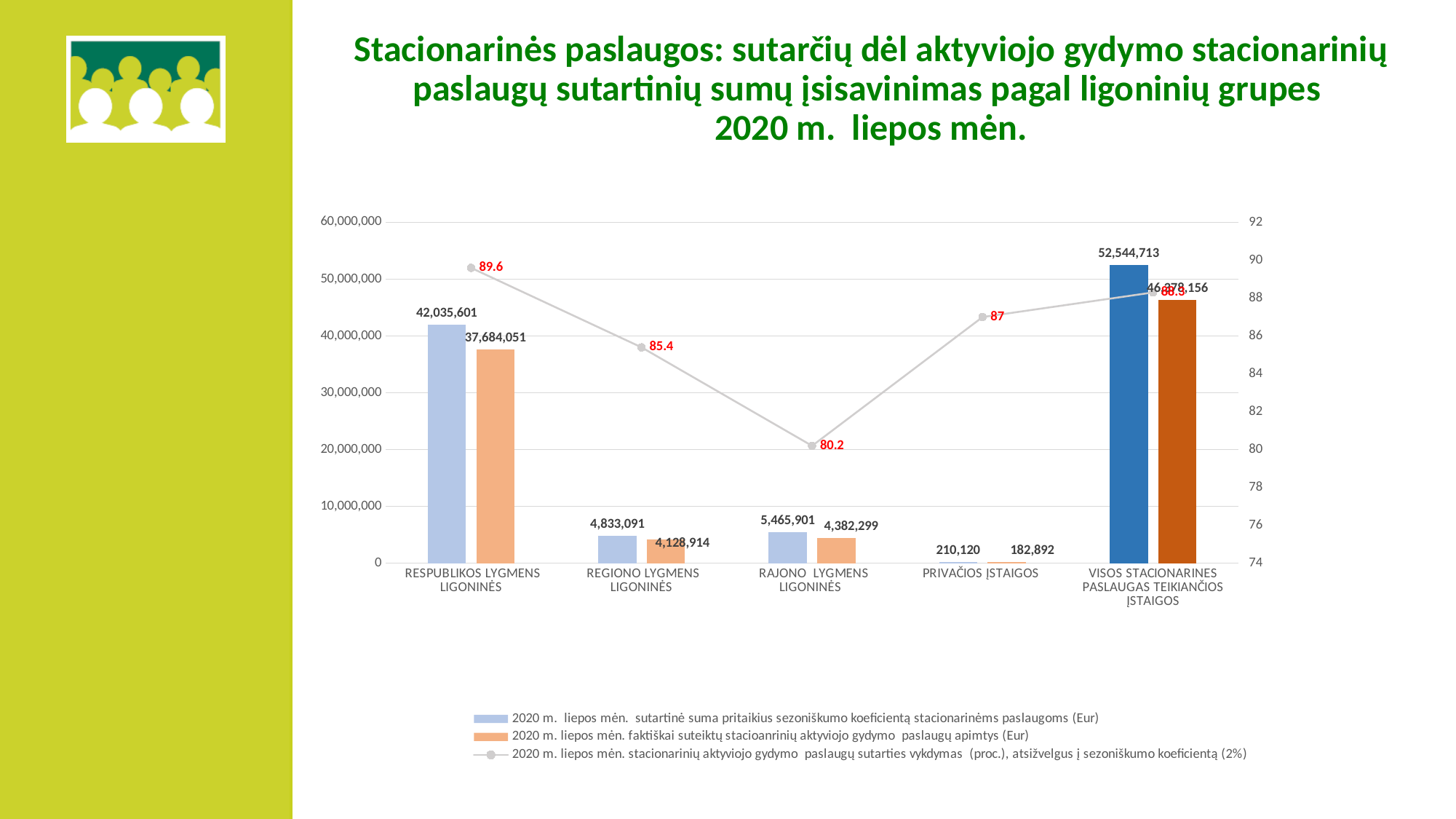
Which category has the lowest actual services (faktiškai suteiktų) bar? PRIVAČIOS ĮSTAIGOS What is the difference between the contracted sum and the actual services value for RESPUBLIKOS LYGMENS LIGONINĖS? 4,351,550 What is the faktiškai suteiktų paslaugų apimtys (actual services) value for REGIONO LYGMENS LIGONINĖS? 4,128,914 What kind of chart is shown on the slide? Bar and line chart How many categories are shown on the x axis? 5 What is the difference between the line values for RESPUBLIKOS LYGMENS LIGONINĖS and REGIONO LYGMENS LIGONINĖS? 4.2 Which category has the highest contracted sum (sutartinė suma) bar? VISOS STACIONARINES PASLAUGAS TEIKIANČIOS ĮSTAIGOS What is the 2020 m. liepos mėn. sutartinė suma (contracted sum) for RESPUBLIKOS LYGMENS LIGONINĖS? 42,035,601 Which category has the lowest value on the sutarties vykdymas (proc.) line? RAJONO LYGMENS LIGONINĖS Which has the larger contracted sum: REGIONO LYGMENS LIGONINĖS or RAJONO LYGMENS LIGONINĖS? RAJONO LYGMENS LIGONINĖS How many series does the legend list? 3 What is the sutarties vykdymas (proc.) line value for RAJONO LYGMENS LIGONINĖS? 80.2